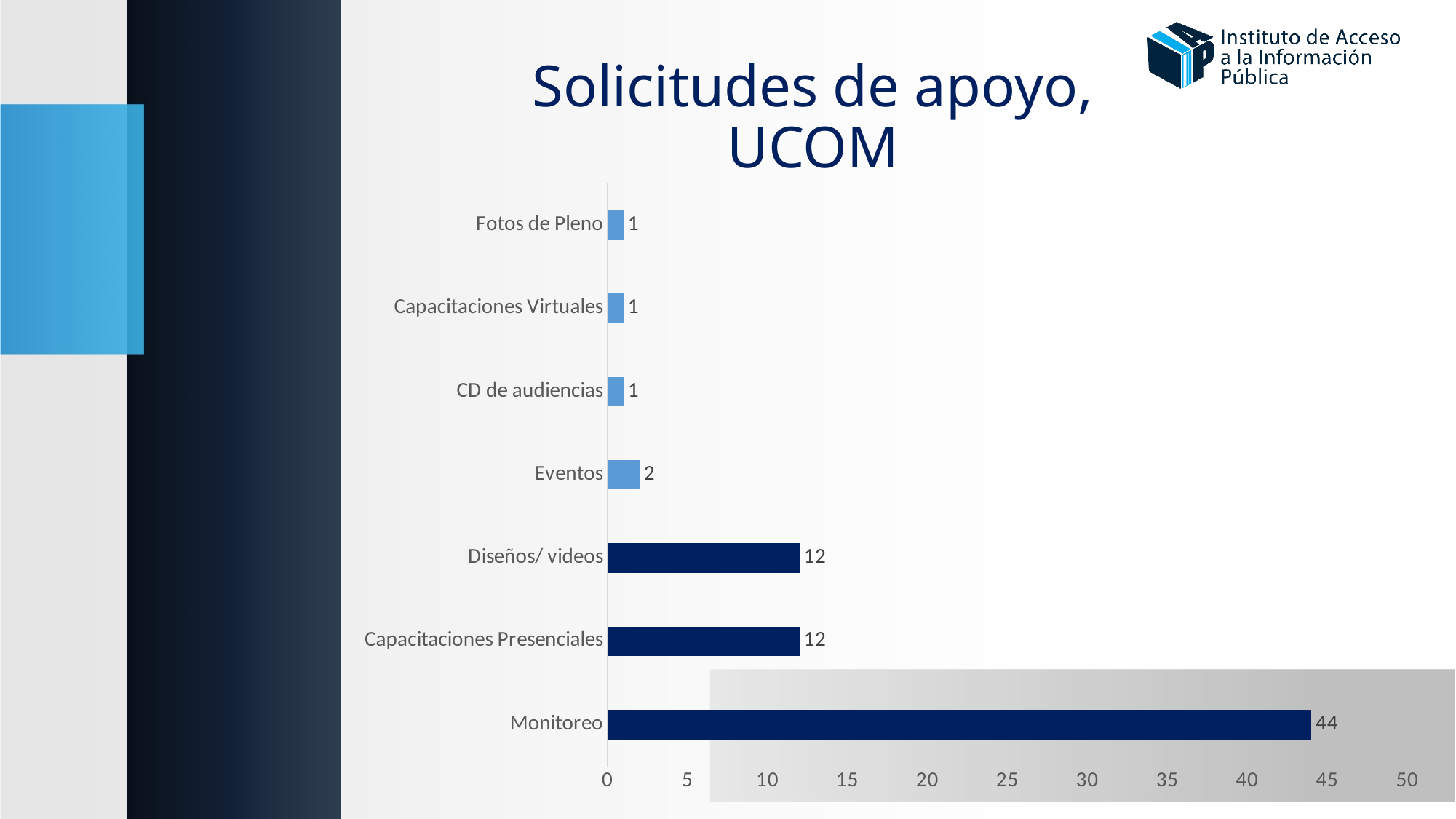
What is the value for Monitoreo? 44 What kind of chart is shown on the slide? bar chart Which is larger, the value for Eventos or the value for Capacitaciones Virtuales? Eventos What is the difference between the values for Eventos and CD de audiencias? 1 What is the difference between the values for Monitoreo and Diseños/ videos? 32 Which category has the highest value? Monitoreo What is the value for Capacitaciones Presenciales? 12 How many categories are shown in the chart? 7 What is the title of the chart on the slide? Solicitudes de apoyo, UCOM What is the value for Eventos? 2 What is the value for Fotos de Pleno? 1 Is the value for Monitoreo greater or less than 40? greater